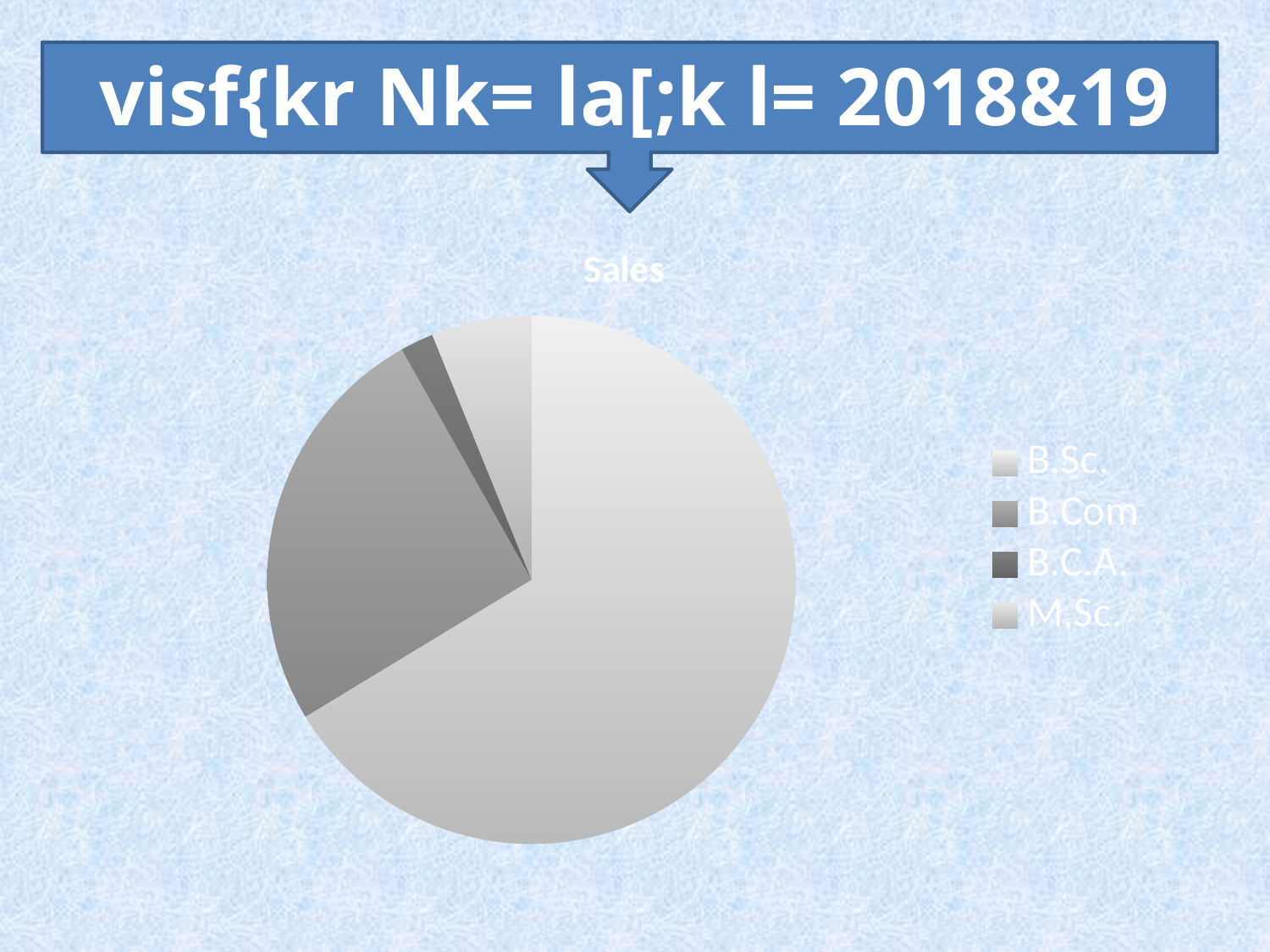
How many slices does the pie chart have? 4 Which category has the largest slice of the pie? B.Sc. How many entries does the chart legend list? 4 Which category has the smallest slice of the pie? B.C.A. What kind of chart is shown on the slide? pie chart Which category has the second-largest slice of the pie? B.Com What is the title of the chart? Sales Which legend entry is listed first in the chart legend? B.Sc. Which slice is larger, B.Sc. or B.Com? B.Sc. Which slice is larger, M.Sc. or B.C.A.? M.Sc. Which slice is larger, B.Com or M.Sc.? B.Com